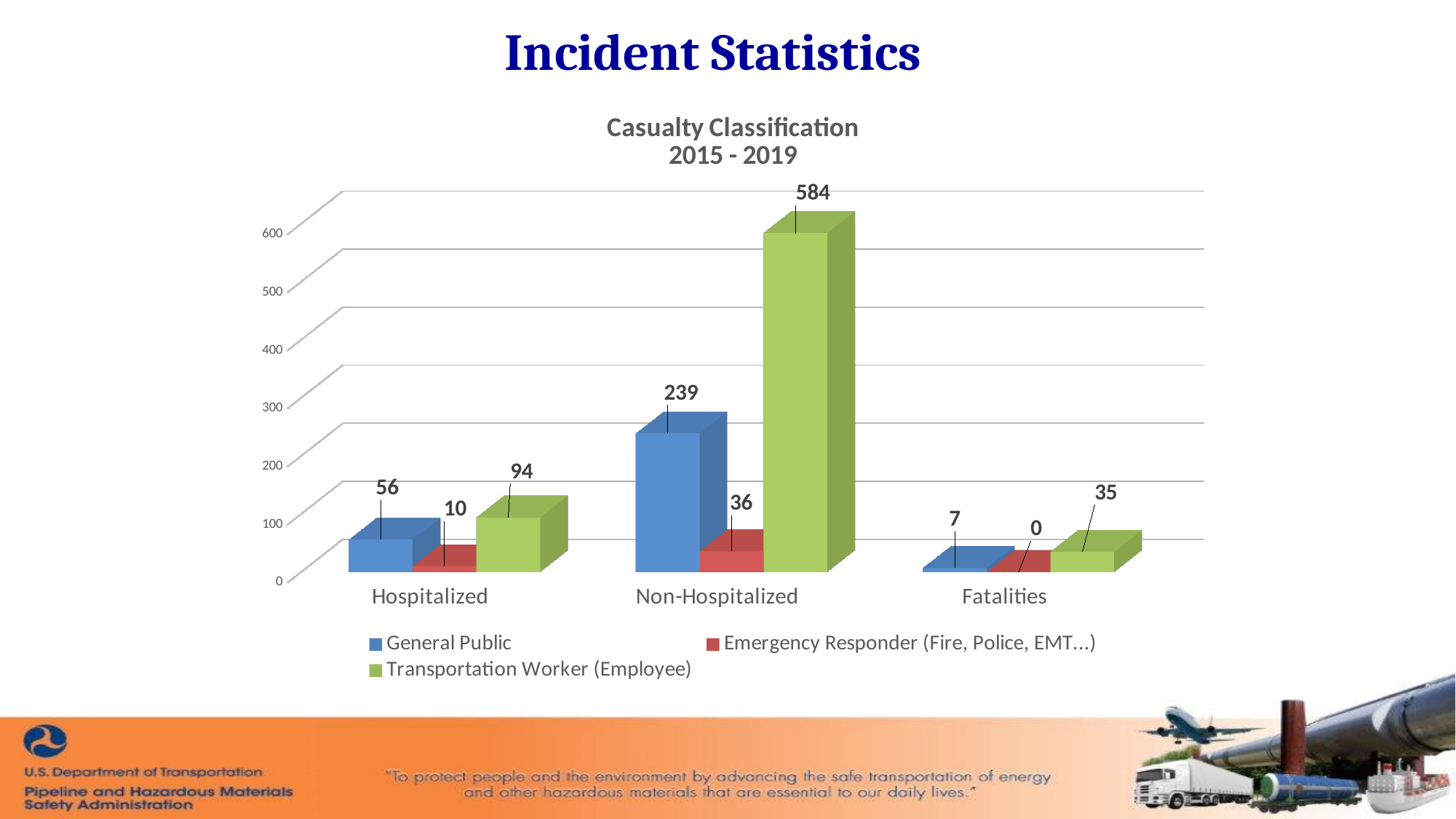
What is the title of the chart? Casualty Classification 2015 - 2019 What is the total of the three series values in the Fatalities category? 42 What is the difference between the Transportation Worker (Employee) and General Public values in the Non-Hospitalized category? 345 What is the value for General Public in the Non-Hospitalized category? 239 Which is larger: the General Public value for Hospitalized or the Transportation Worker (Employee) value for Fatalities? General Public value for Hospitalized How many series does the legend list? 3 What kind of chart is shown on the slide? Bar chart How many categories are shown on the x axis? 3 What is the value for Emergency Responder (Fire, Police, EMT...) in the Fatalities category? 0 What is the value for Transportation Worker (Employee) in the Hospitalized category? 94 Which series has the lowest value in the Hospitalized category? Emergency Responder (Fire, Police, EMT...) Which series has the highest value in the Non-Hospitalized category? Transportation Worker (Employee)